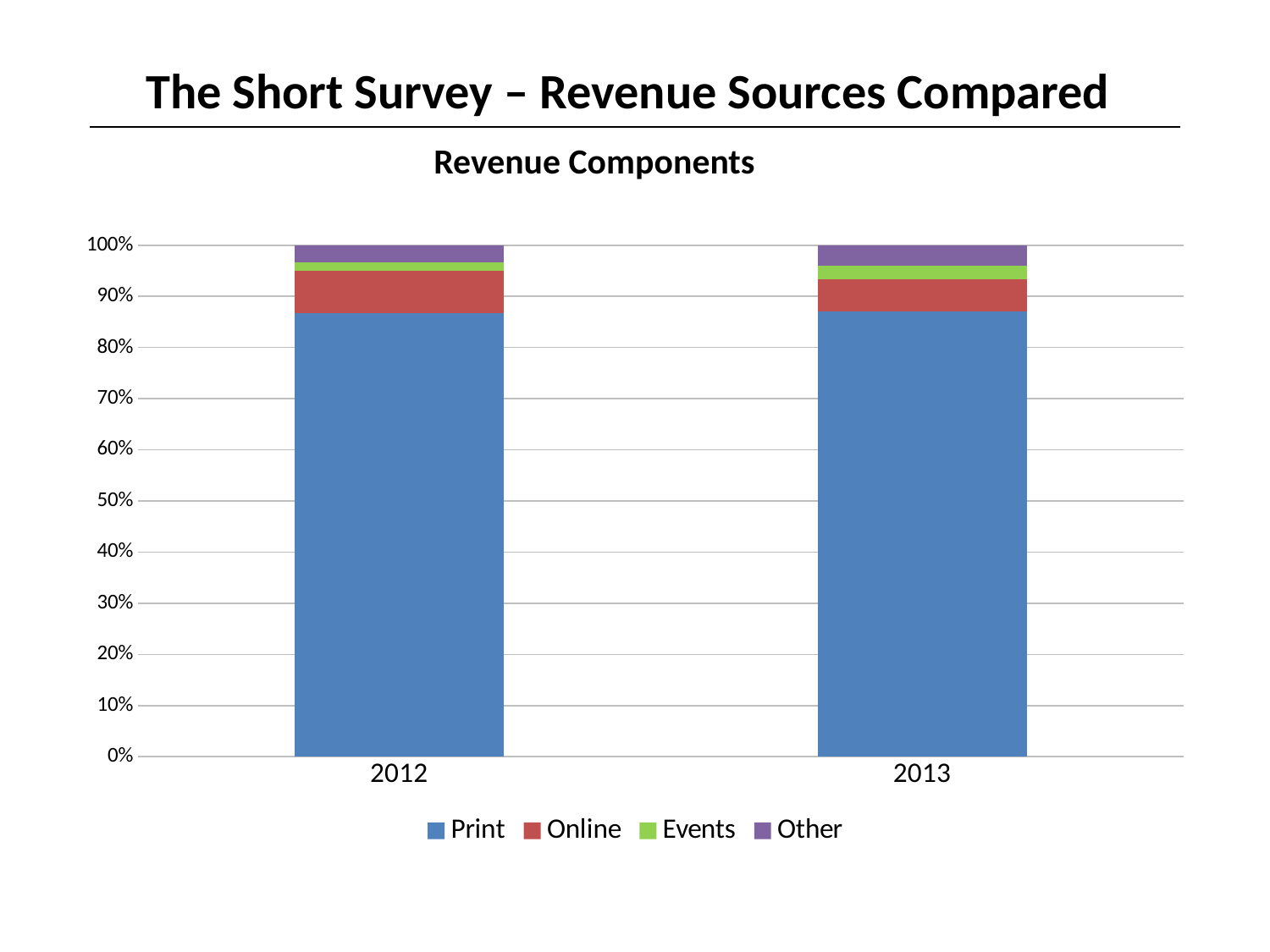
Which revenue source makes up the largest share of the 2013 bar? Print Which series is shown in blue in the legend? Print How many years are shown on the x axis? 2 Is the Events share larger in 2012 or in 2013? 2013 What is the title of the chart? Revenue Components What kind of chart is shown on the slide? Stacked bar chart Which revenue source makes up the largest share of the 2012 bar? Print Is the Print share in 2012 greater or less than 80%? greater Is the Print share in 2013 greater or less than 90%? less How many series does the legend list? 4 In 2012, which is larger, the Print share or the Online share? Print What is the total height of the stacked bar for 2013? 100%